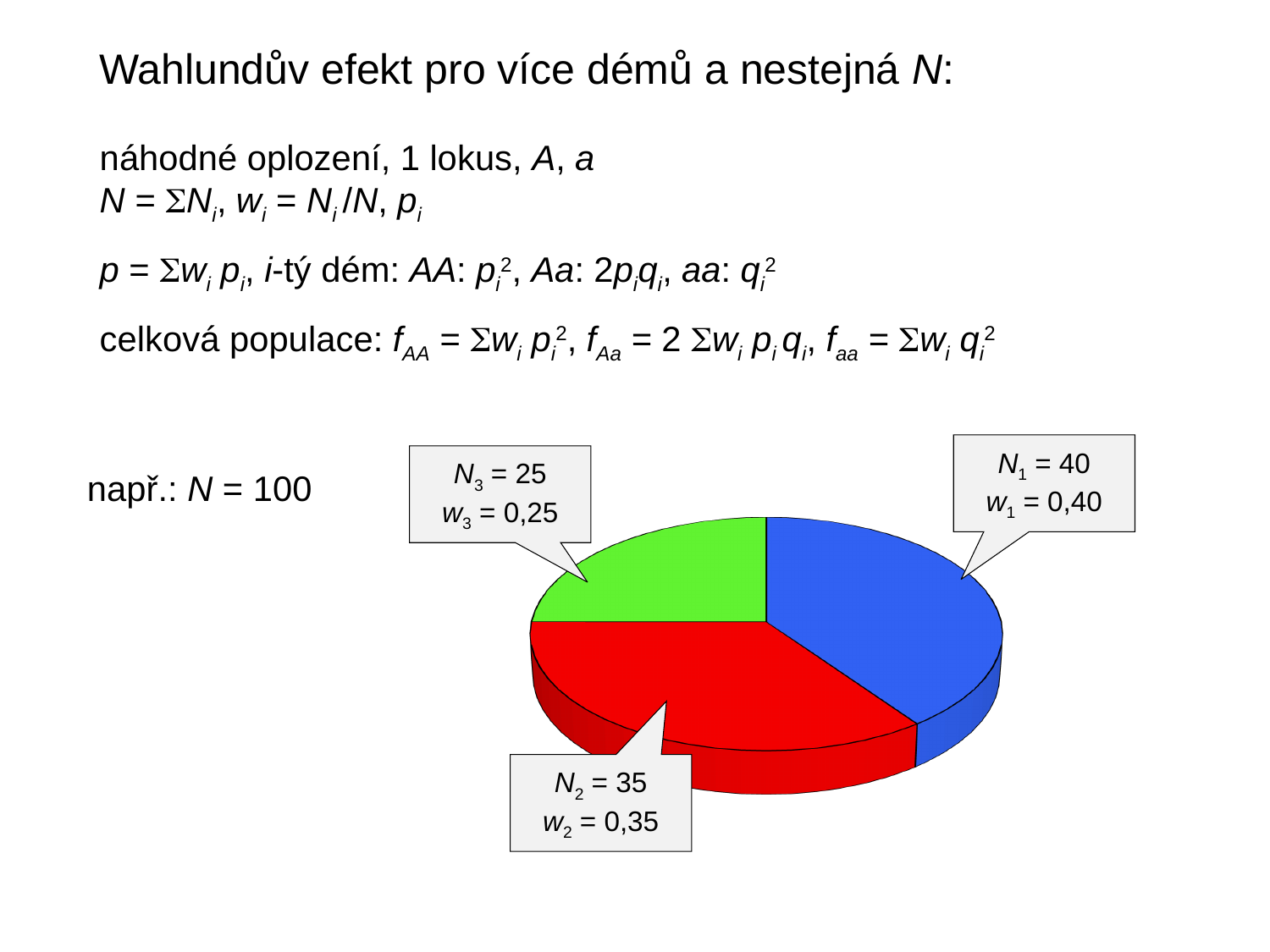
What is the value of w2 shown in the callout for the red slice? 0,35 Which dém has the largest N in the pie chart? N1 = 40 What is the value of N3 shown in the callout for the green slice? 25 What is the difference between N1 and N3? 15 What share of the pie does the green slice (N3) represent, as given by w3? 0,25 What is the value of N2 shown in the callout for the red slice? 35 How many slices does the pie chart have? 3 What colour is the slice for N1? blue Which dém has the smallest N in the pie chart? N3 = 25 What is the value of N1 shown in the callout for the blue slice? 40 Which is larger, N2 or N3? N2 What kind of chart is shown on the slide? pie chart